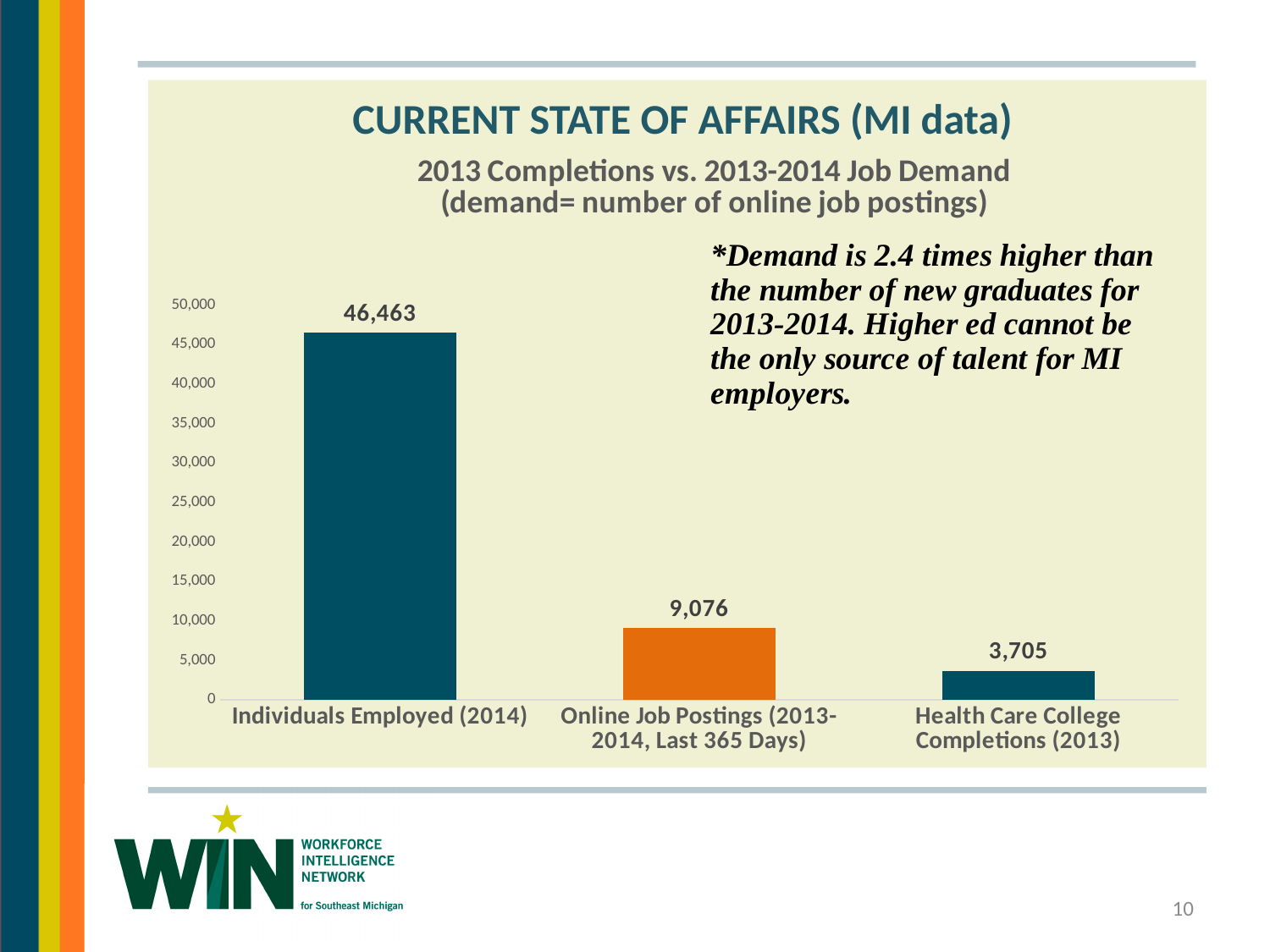
What is the difference between Online Job Postings (2013-2014, Last 365 Days) and Health Care College Completions (2013)? 5,371 What is the difference between Individuals Employed (2014) and Online Job Postings (2013-2014, Last 365 Days)? 37,387 Which category has the lowest value? Health Care College Completions (2013) What is the value for Individuals Employed (2014)? 46,463 Which category has the highest value? Individuals Employed (2014) What is the value for Online Job Postings (2013-2014, Last 365 Days)? 9,076 What kind of chart is shown on the slide? Bar chart How many categories are shown in the chart? 3 Which is larger, Online Job Postings (2013-2014, Last 365 Days) or Health Care College Completions (2013)? Online Job Postings (2013-2014, Last 365 Days) What is the value for Health Care College Completions (2013)? 3,705 Is the value for Individuals Employed (2014) greater or less than 45,000? greater What is the title of the chart? 2013 Completions vs. 2013-2014 Job Demand (demand= number of online job postings)